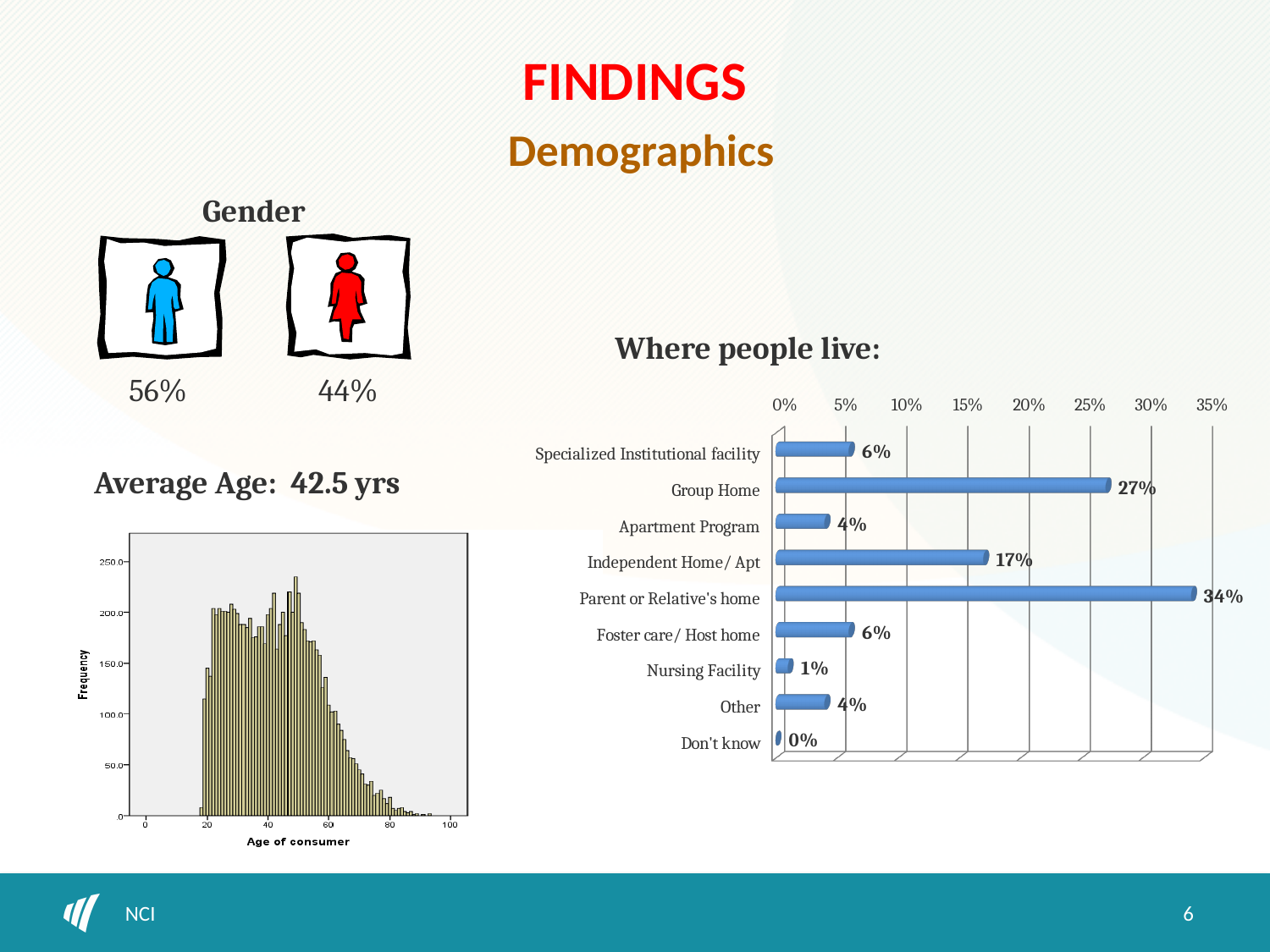
In the 'Where people live:' chart, what is the value for Nursing Facility? 1% In the 'Where people live:' chart, how many categories are shown? 9 What kind of chart is shown under 'Average Age: 42.5 yrs' on the left of the slide? Histogram In the 'Where people live:' chart, what is the value for Group Home? 27% In the 'Where people live:' chart, what is the difference between Parent or Relative's home and Group Home? 7% In the 'Where people live:' chart, what is the value for Independent Home/Apt? 17% In the 'Where people live:' chart, which category has the lowest value? Don't know In the 'Where people live:' chart, what is the value for Foster care/Host home? 6% What kind of chart is the 'Where people live:' chart? Bar chart What is the x-axis label of the histogram on the left of the slide? Age of consumer In the 'Where people live:' chart, which category has the highest value? Parent or Relative's home In the 'Where people live:' chart, which is larger, Specialized Institutional facility or Apartment Program? Specialized Institutional facility